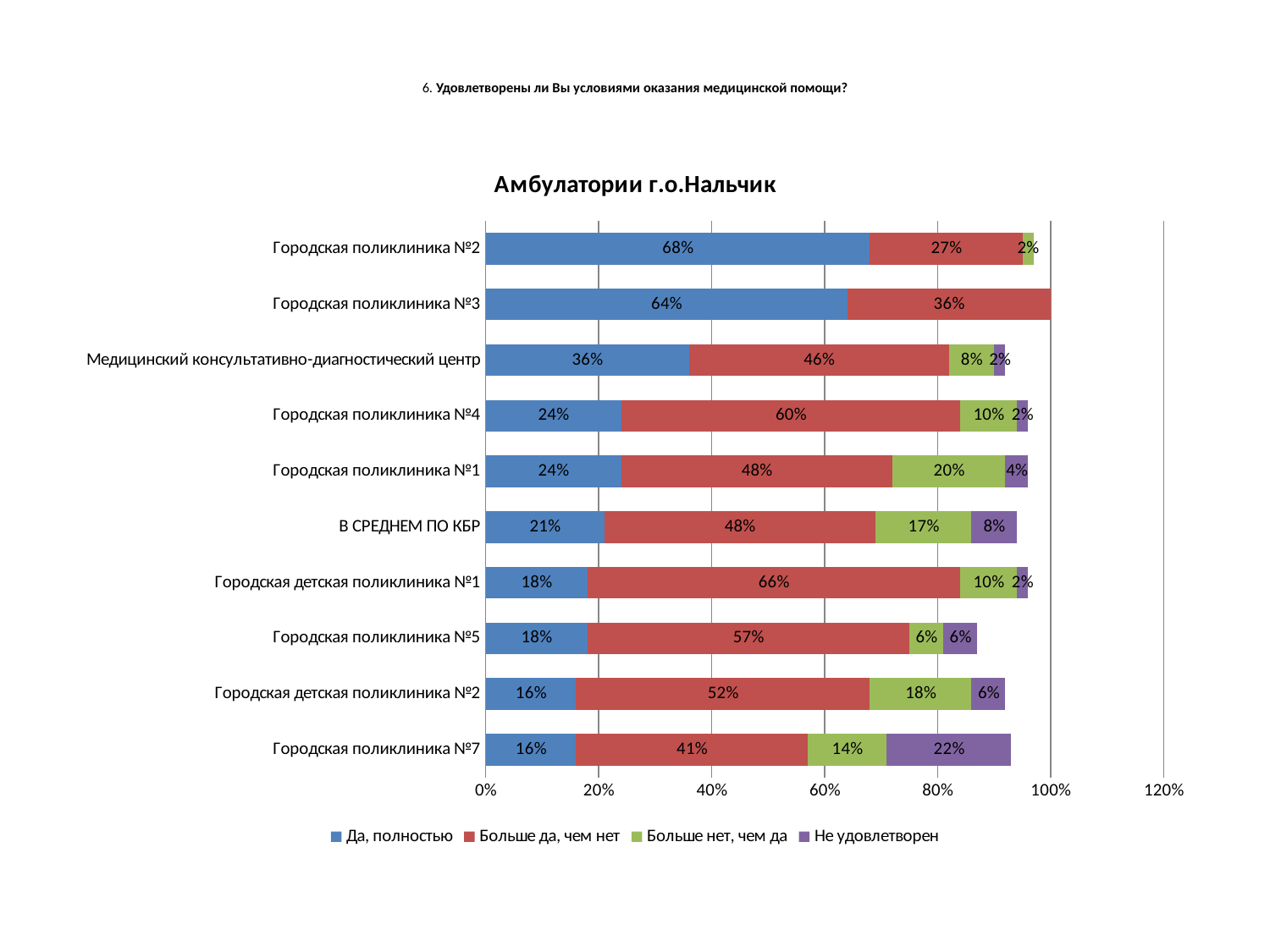
How many categories (institutions) are shown on the chart? 10 Which category has the highest value for 'Да, полностью'? Городская поликлиника №2 What type of chart is shown on the slide? bar chart How many series does the legend list? 4 What is the difference between the 'Больше да, чем нет' values for Городская поликлиника №4 and Городская поликлиника №7? 19% What is the value of 'Не удовлетворен' for Городская поликлиника №7? 22% Which is larger: the 'Больше нет, чем да' value for Городская поликлиника №1 or for В СРЕДНЕМ ПО КБР? Городская поликлиника №1 What is the title of the chart? Амбулатории г.о.Нальчик What is the value of 'Больше да, чем нет' for Городская детская поликлиника №1? 66% What is the value of 'Да, полностью' for Городская поликлиника №3? 64% What is the total of the stacked bar for Городская поликлиника №7? 93% Which category has the highest value for 'Не удовлетворен'? Городская поликлиника №7